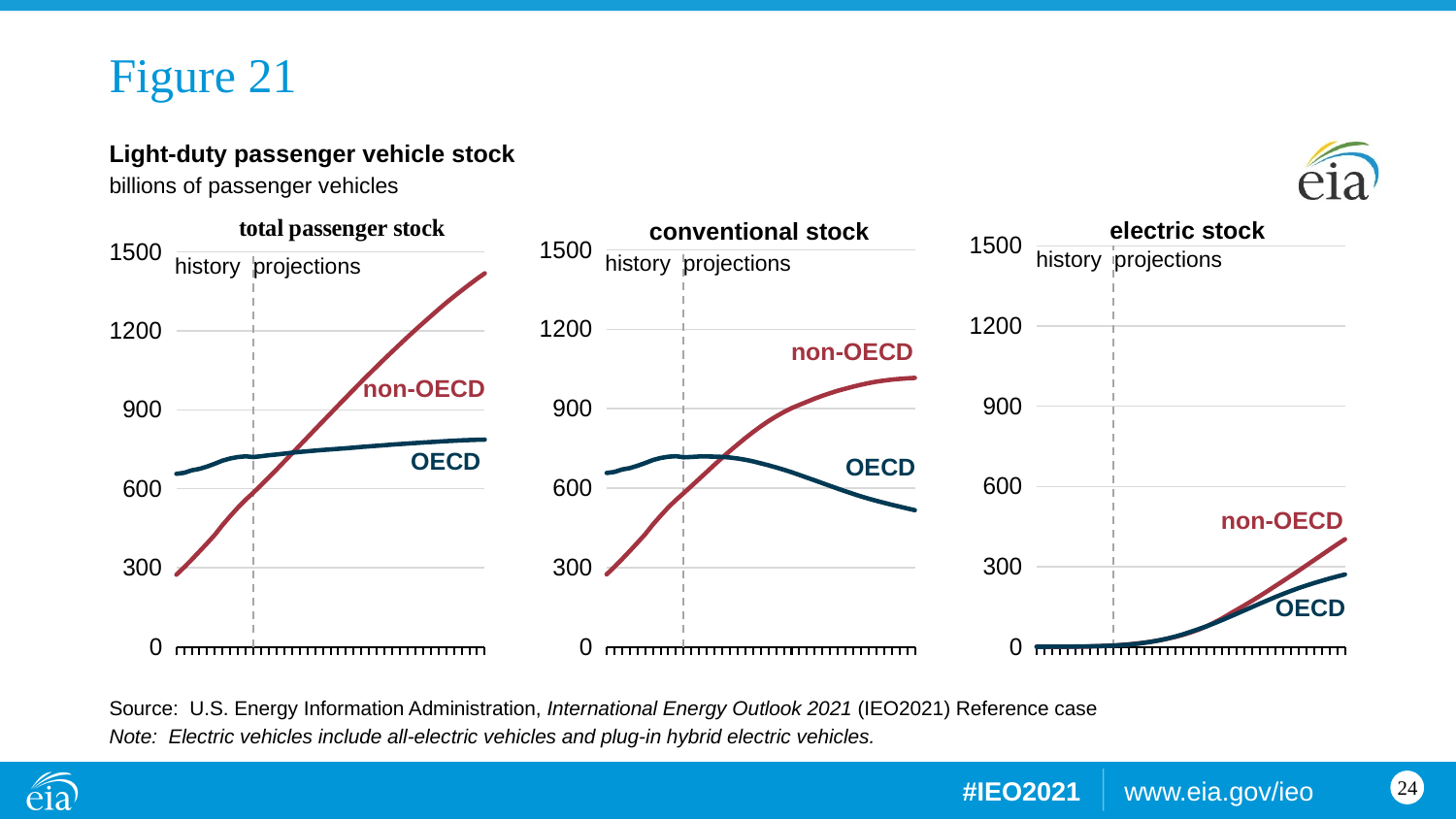
What unit is given for the values in the charts? billions of passenger vehicles In the conventional stock chart, is the final projected value for non-OECD greater or less than 900? greater In the conventional stock chart, how many series are plotted? 2 In the conventional stock chart, is the final projected value for OECD greater or less than 600? less In the total passenger stock chart, which series is higher at the end of the projection period, non-OECD or OECD? non-OECD In the electric stock chart, which series is higher at the end of the projection period, OECD or non-OECD? non-OECD In the electric stock chart, is the final projected value for non-OECD greater or less than 300? greater In the conventional stock chart, does the OECD line rise or fall over the projection period? fall What kind of chart is used for the total passenger stock panel? line chart How many separate chart panels are shown on the slide? 3